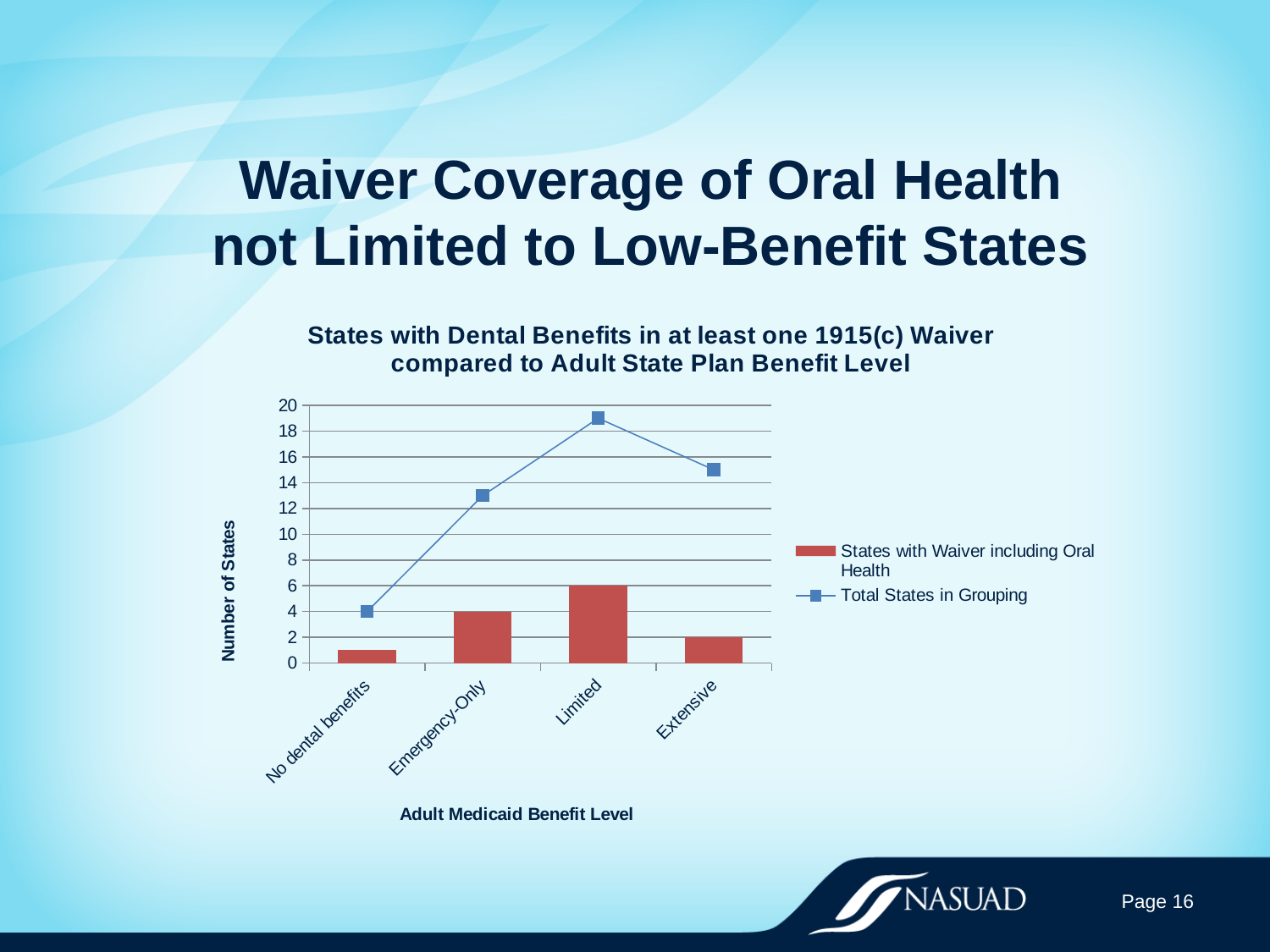
Is the Total States in Grouping value for Limited greater or less than 16? greater Is the Total States in Grouping value for Emergency-Only greater or less than 10? greater Which has more States with Waiver including Oral Health, Extensive or Emergency-Only? Emergency-Only What is the title of the x axis? Adult Medicaid Benefit Level Which benefit level has the lowest number of States with Waiver including Oral Health? No dental benefits What is the difference between the States with Waiver including Oral Health for Limited and for Emergency-Only? 2 Which benefit level has the highest number of States with Waiver including Oral Health? Limited How many States with Waiver including Oral Health are shown for the Limited benefit level? 6 What kind of chart is shown on the slide? A combined bar and line chart How many series does the legend list? 2 How many States with Waiver including Oral Health are shown for the Emergency-Only benefit level? 4 How many Adult Medicaid Benefit Level categories are shown on the x axis? 4